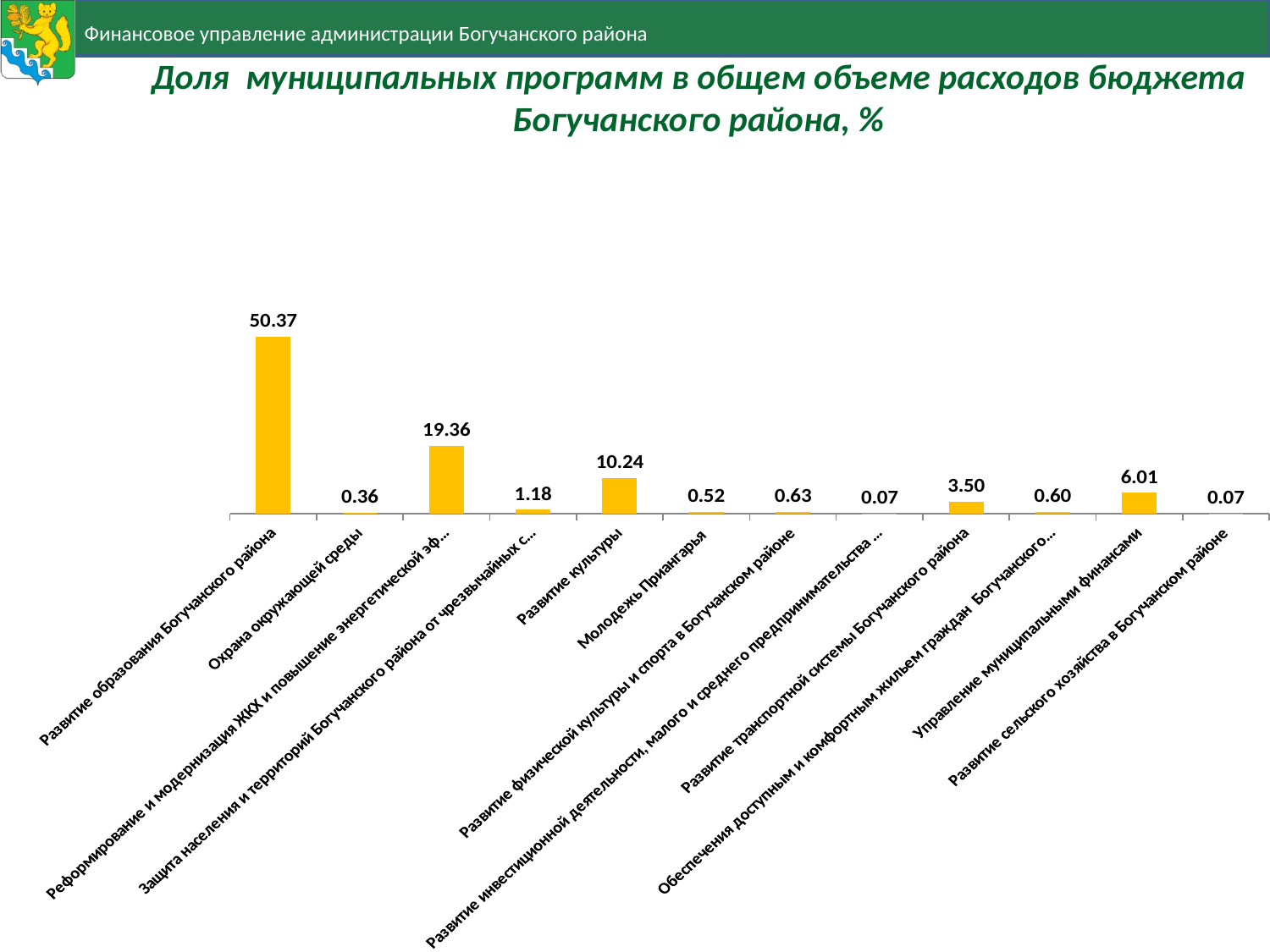
What is the difference between the values for «Развитие образования Богучанского района» and «Реформирование и модернизация ЖКХ и повышение энергетической эф…»? 31.01 What is the value for «Развитие культуры»? 10.24 What is the value for «Развитие образования Богучанского района»? 50.37 What is the value for «Управление муниципальными финансами»? 6.01 What is the lowest value shown on the chart? 0.07 What is the value for «Развитие транспортной системы Богучанского района»? 3.50 What type of chart is shown on the slide? bar chart What is the title of the chart? Доля муниципальных программ в общем объеме расходов бюджета Богучанского района, % What is the value for «Молодежь Приангарья»? 0.52 Which category has the highest value? Развитие образования Богучанского района Which is larger: the value for «Развитие культуры» or the value for «Управление муниципальными финансами»? Развитие культуры How many categories (bars) are shown on the chart? 12